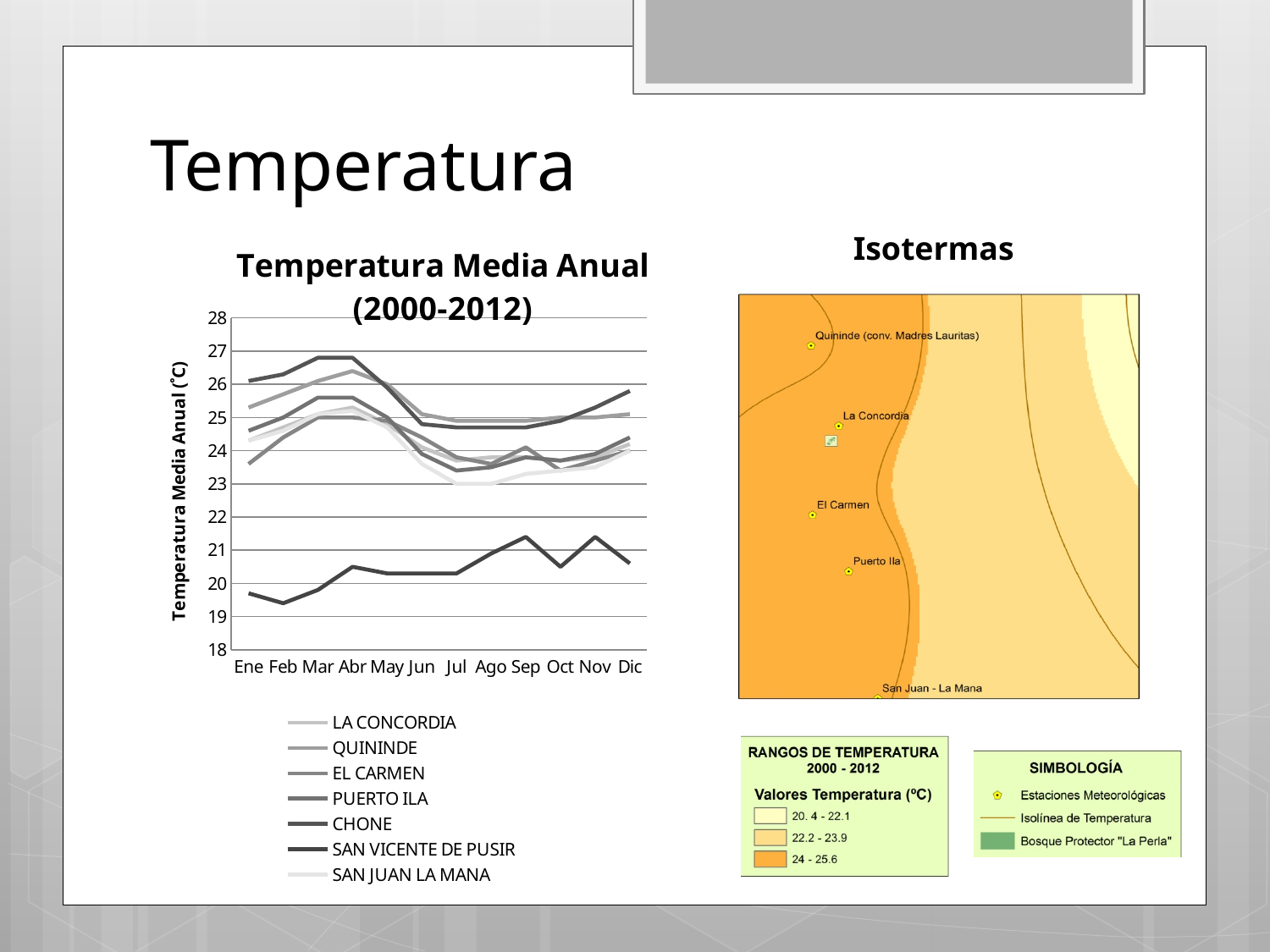
In the 'Temperatura Media Anual (2000-2012)' chart, does the lowest line rise or fall from Ene to Sep? rise In the 'Temperatura Media Anual (2000-2012)' chart, is the value of the lowest line in Sep greater or less than 21? greater How many series does the legend of the 'Temperatura Media Anual (2000-2012)' chart list? 7 What is the last series listed in the legend of the 'Temperatura Media Anual (2000-2012)' chart? SAN JUAN LA MANA In the 'Temperatura Media Anual (2000-2012)' chart, is the value of the highest line in Mar greater or less than 26? greater How many months are shown on the x axis of the 'Temperatura Media Anual (2000-2012)' chart? 12 In the 'Temperatura Media Anual (2000-2012)' chart, is the value of the lowest line in Ene greater or less than 20? less What type of chart is 'Temperatura Media Anual (2000-2012)'? line chart In the 'Temperatura Media Anual (2000-2012)' chart, does the highest line rise or fall from Abr to Jul? fall What is the label of the y axis of the 'Temperatura Media Anual (2000-2012)' chart? Temperatura Media Anual (°C)